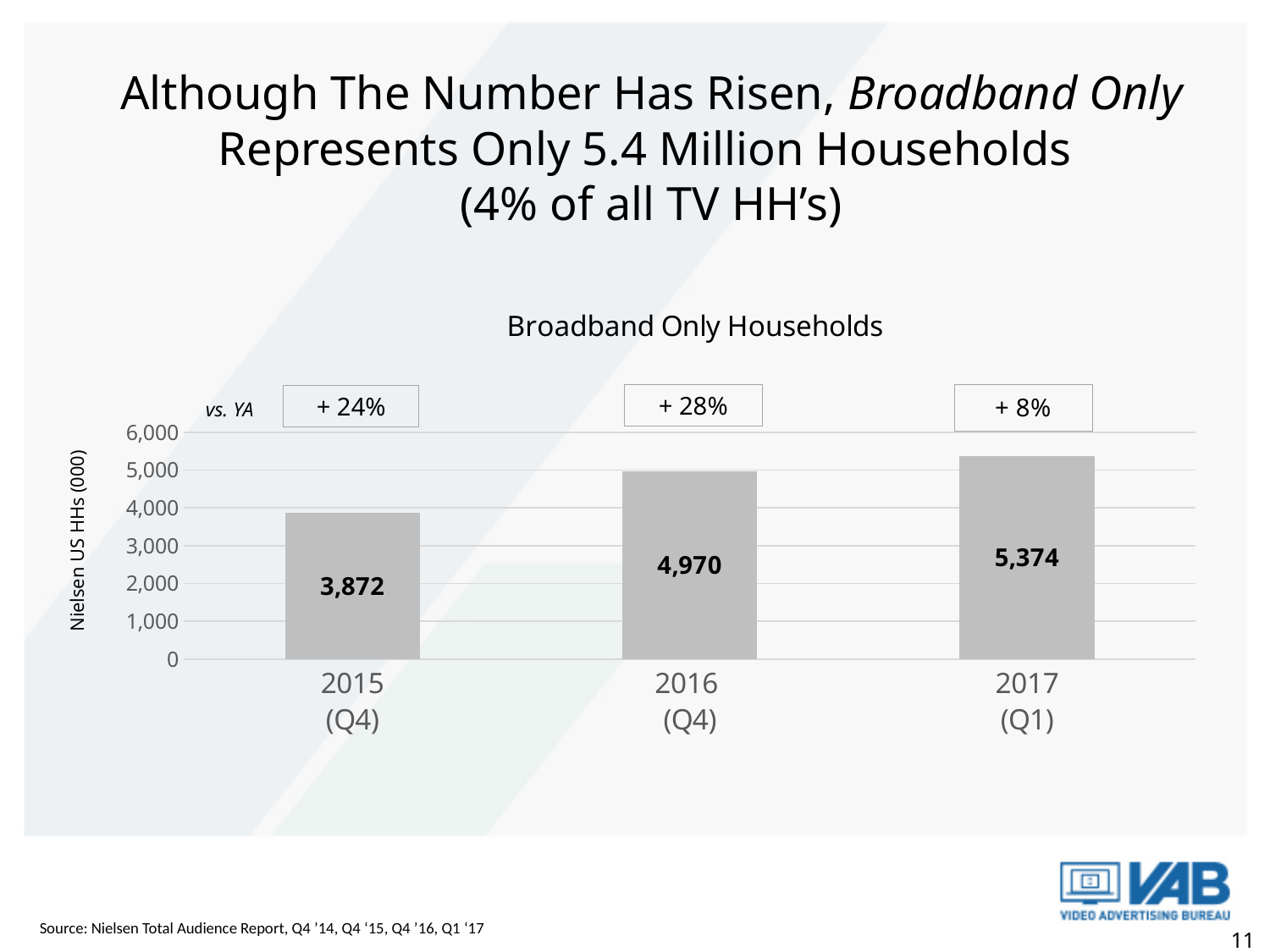
Is the value for 2016 (Q4) greater or less than 4,000? greater Which period has the highest value in the Broadband Only Households chart? 2017 (Q1) What is the value for 2015 (Q4) in the Broadband Only Households chart? 3,872 How many bars are shown in the Broadband Only Households chart? 3 What is the value for 2017 (Q1) in the Broadband Only Households chart? 5,374 Which is larger in the Broadband Only Households chart, the value for 2016 (Q4) or 2017 (Q1)? 2017 (Q1) What kind of chart is shown on the slide? Bar chart Do the values rise or fall from 2015 (Q4) to 2017 (Q1) in the Broadband Only Households chart? Rise What is the difference between the 2017 (Q1) and 2015 (Q4) values in the Broadband Only Households chart? 1,502 What is the difference between the 2016 (Q4) and 2015 (Q4) values in the Broadband Only Households chart? 1,098 Which period has the lowest value in the Broadband Only Households chart? 2015 (Q4) What is the value for 2016 (Q4) in the Broadband Only Households chart? 4,970